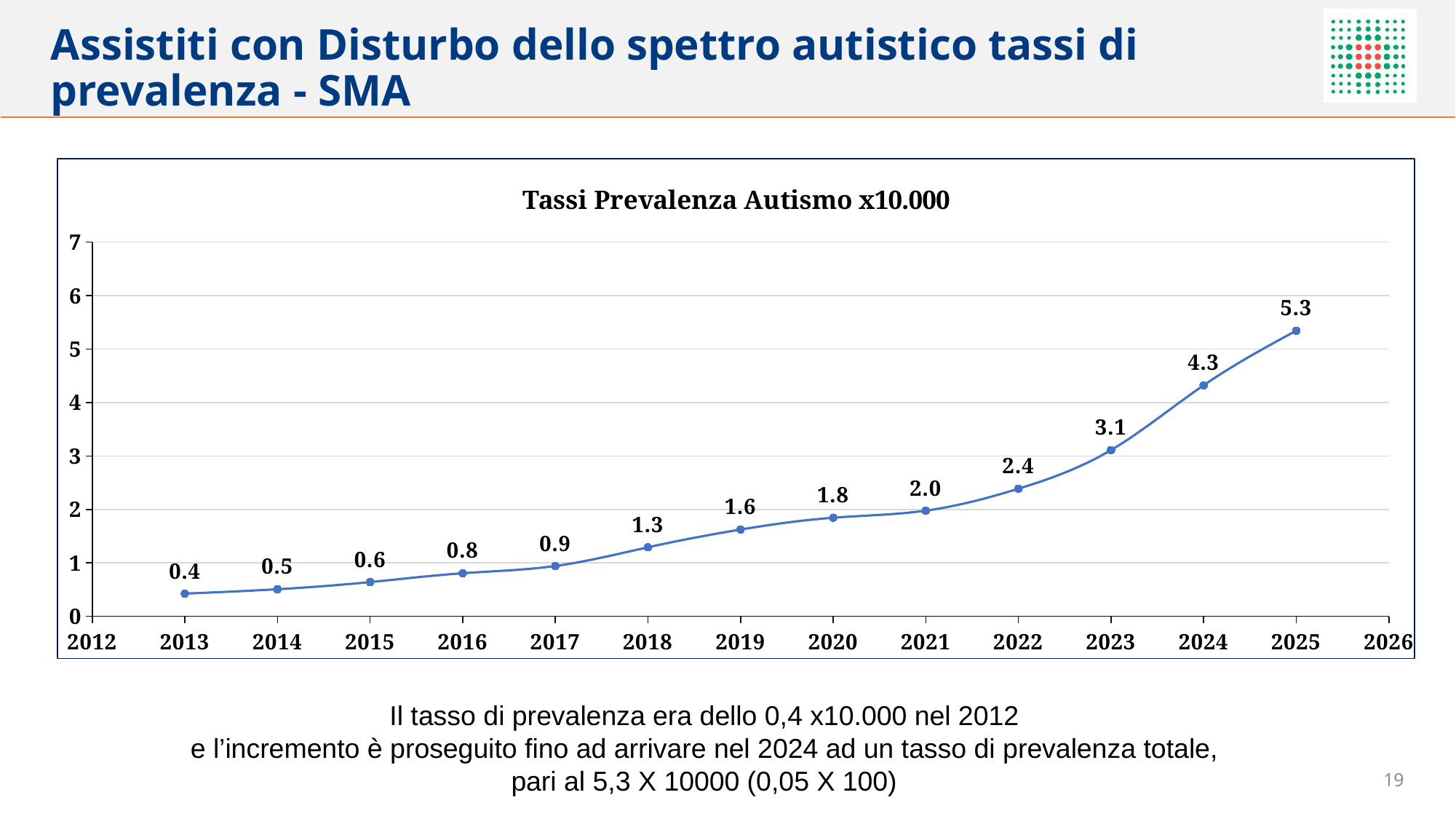
How many data points are plotted on the chart? 13 Do the values rise or fall from 2013 to 2025? rise Is the value for 2024 greater or less than 4? greater Which year has the highest value? 2025 What is the difference between the values for 2025 and 2024? 1.0 Which is larger, the value for 2019 or the value for 2022? 2022 What is the value for 2018? 1.3 What is the value for 2021? 2.0 What is the value for 2025? 5.3 What kind of chart is shown? line chart Which year has the lowest value? 2013 What is the difference between the values for 2023 and 2013? 2.7